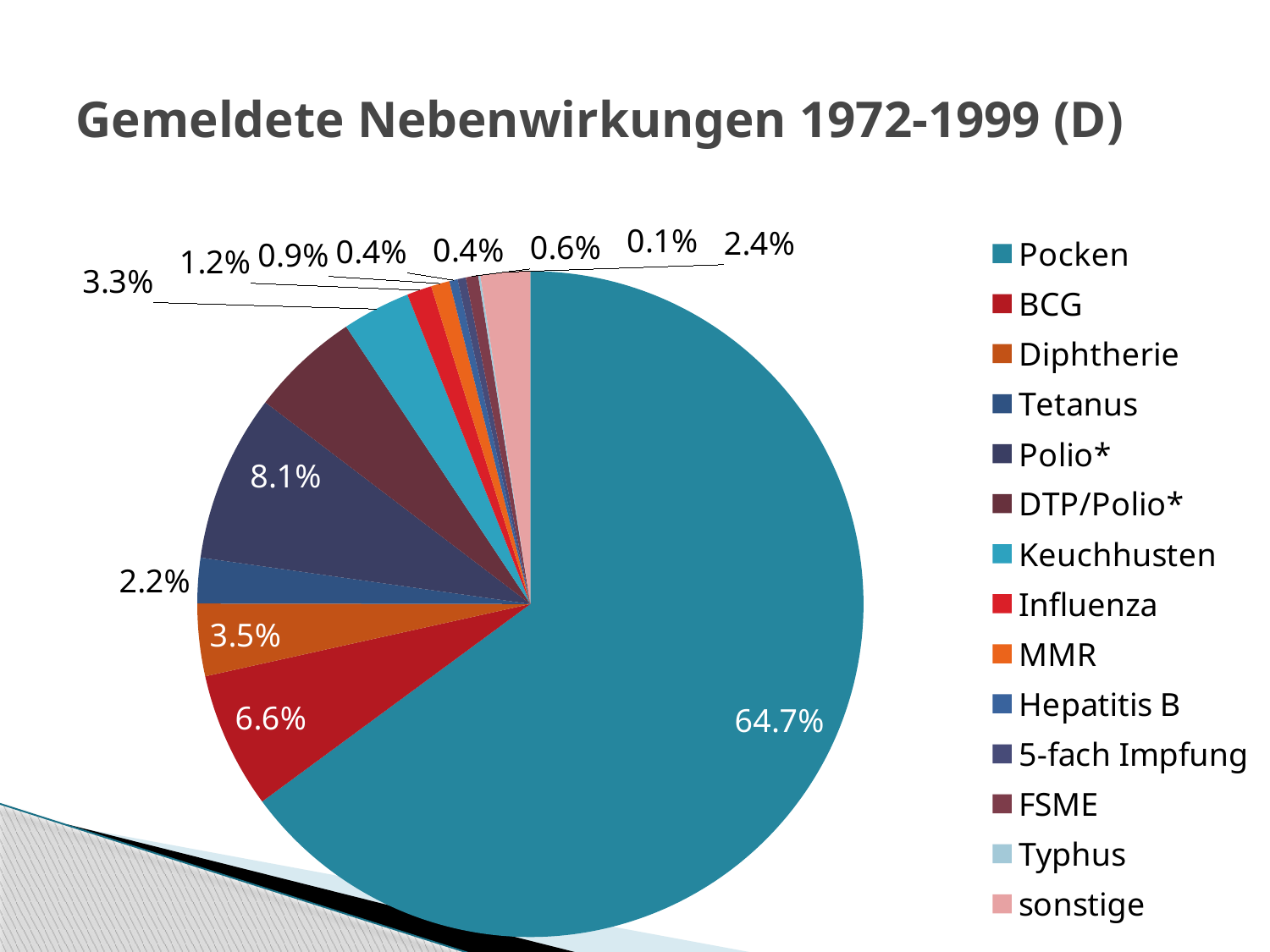
Which is larger, the slice for BCG or the slice for Polio*? Polio* What is the value for sonstige? 2.4% What is the value for Polio*? 8.1% Which category has the largest slice of the pie? Pocken What share of the pie does Pocken account for? 64.7% What is the title of the chart? Gemeldete Nebenwirkungen 1972-1999 (D) What is the value for Diphtherie? 3.5% What is the difference between the Pocken share and the Polio* share? 56.6 percentage points What kind of chart is shown on the slide? pie chart What is the value for BCG? 6.6% How many categories does the legend list? 14 What is the value for Tetanus? 2.2%